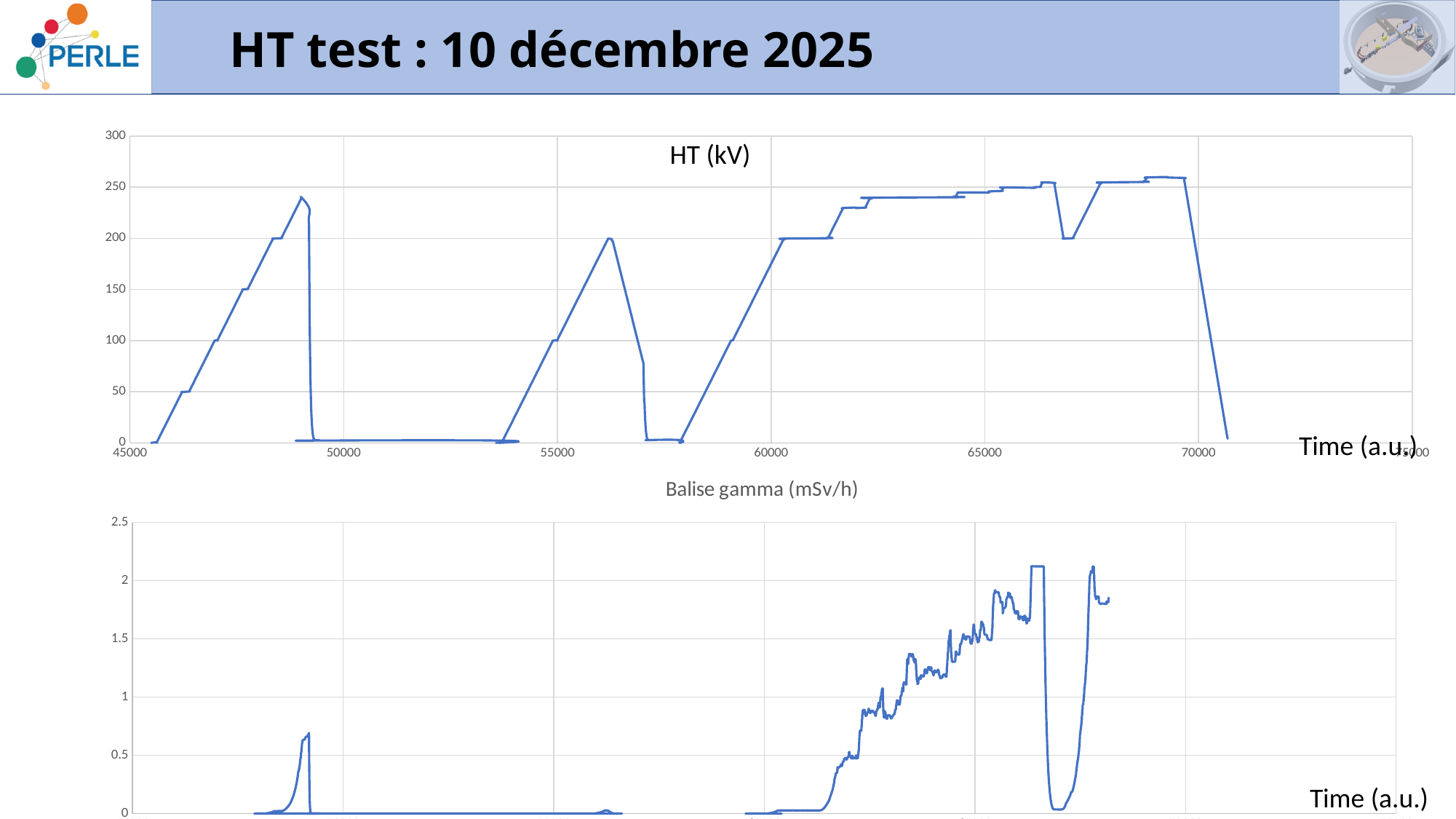
In the top chart "HT (kV)", is the peak value of the first ramp (just before 50000) greater or less than 200? greater What is the title of the bottom chart? Balise gamma (mSv/h) How many charts are shown on the slide? 2 What is the x-axis label of the top chart "HT (kV)"? Time (a.u.) In the top chart "HT (kV)", is the value at 50000 greater or less than 50? less In the top chart "HT (kV)", is the value at 65000 greater or less than 200? greater What kind of chart is the bottom chart titled "Balise gamma (mSv/h)"? line chart In the top chart "HT (kV)", does the value rise or fall between 58000 and 60000 on the x axis? rise What kind of chart is the top chart titled "HT (kV)"? line chart